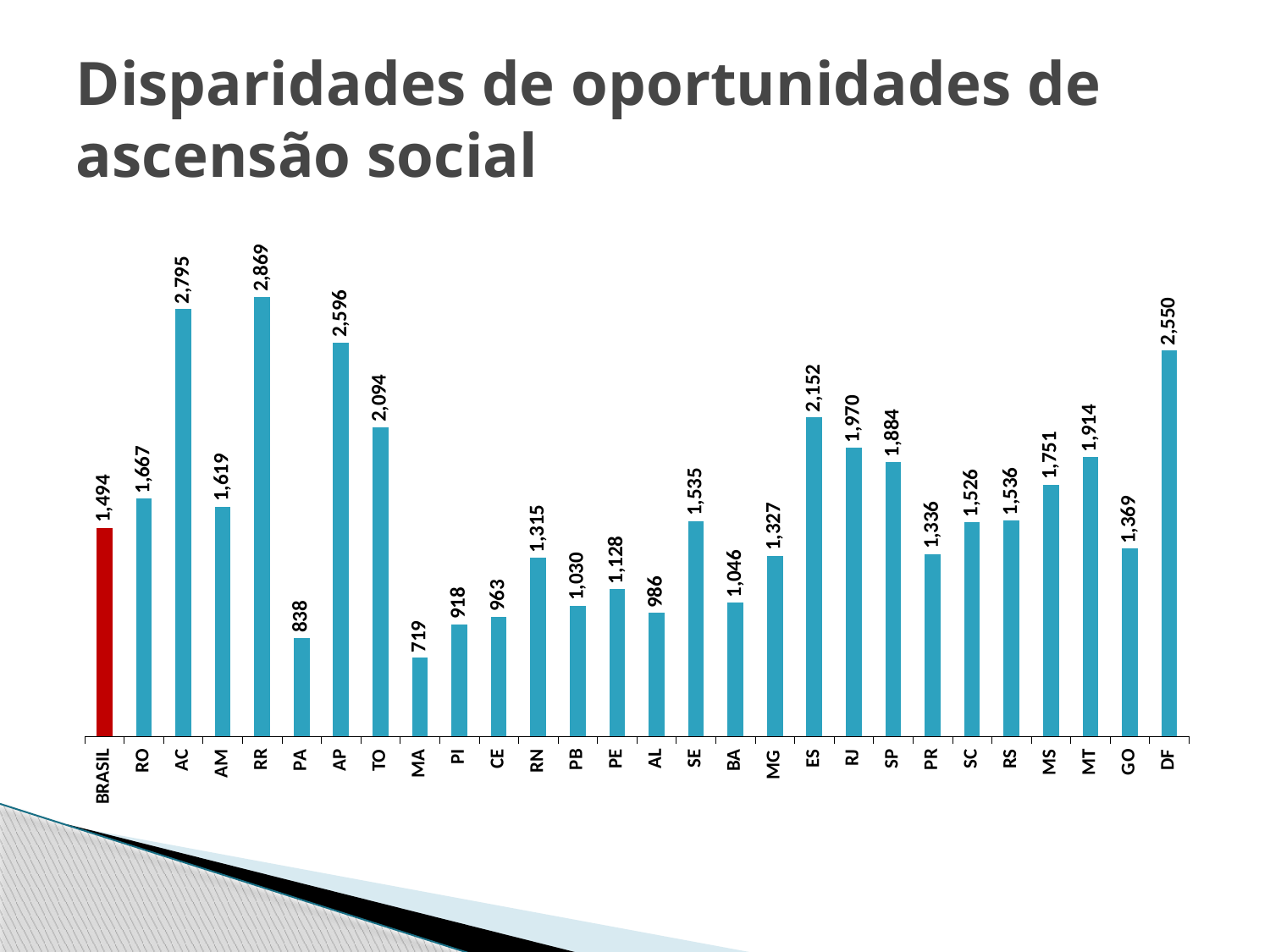
Which has a larger value, RJ or SP? RJ Which bar is coloured red instead of blue? BRASIL What is the value shown for BRASIL? 1,494 What is the value shown for MA? 719 What kind of chart is shown on the slide? Bar chart What is the value shown for DF? 2,550 What is the difference between the values for DF and BRASIL? 1,056 Which category has the lowest value? MA What is the difference between the values for RR and AC? 74 How many categories are shown on the x axis? 28 Which category has the highest value? RR What is the value shown for SP? 1,884